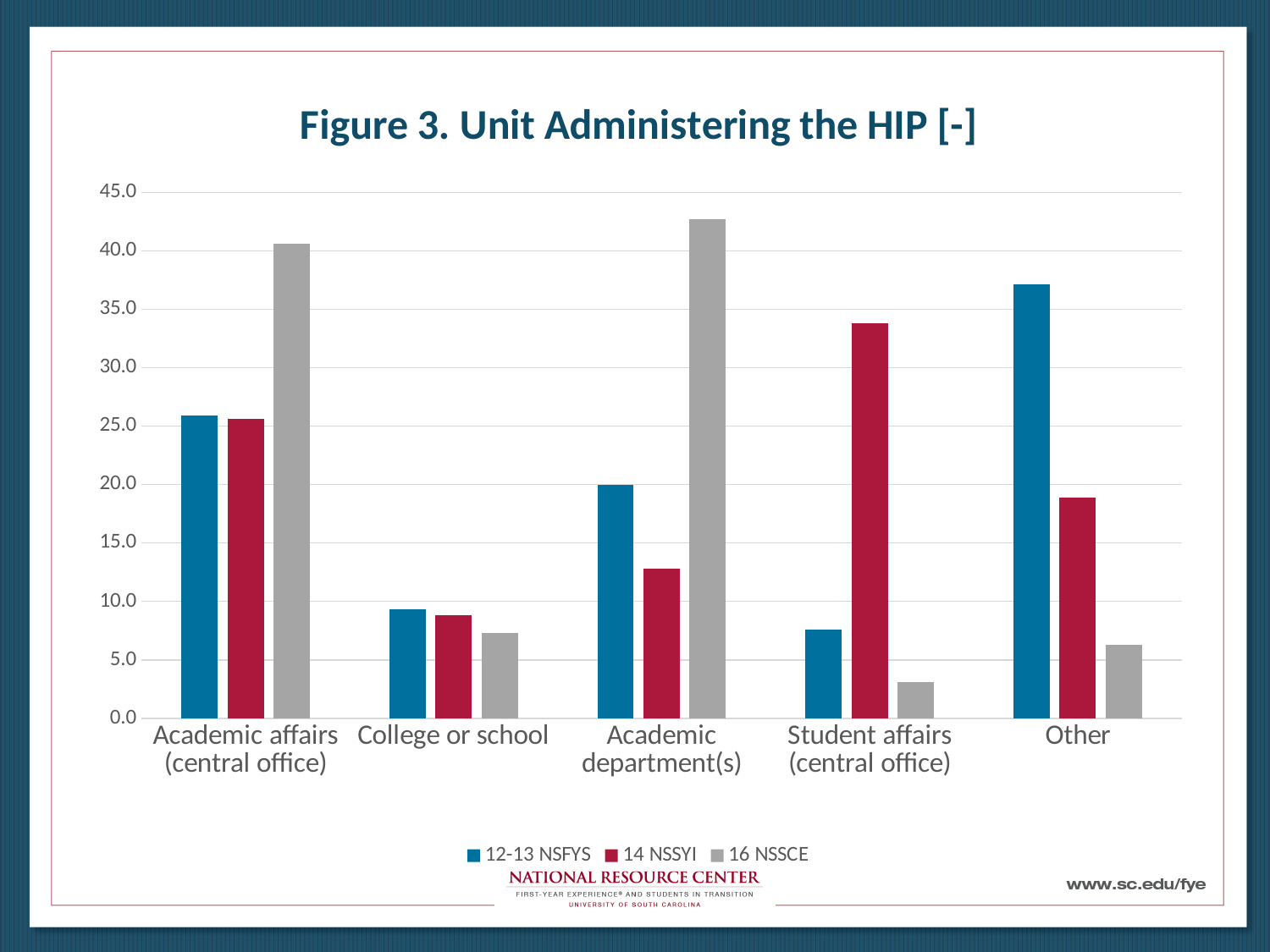
What is the title of the chart? Figure 3. Unit Administering the HIP [-] Which category has the highest value for the 16 NSSCE series? Academic department(s) Is the 14 NSSYI value for Student affairs (central office) greater or less than 30.0? greater Which category has the highest value for the 12-13 NSFYS series? Other Is the 16 NSSCE value for Academic affairs (central office) greater or less than 35.0? greater How many series does the legend list? 3 Which category has the highest value for the 14 NSSYI series? Student affairs (central office) Is the 16 NSSCE value for Other greater or less than 10.0? less How many categories are shown on the x axis? 5 For the Other category, which series has the larger value: 12-13 NSFYS or 14 NSSYI? 12-13 NSFYS What kind of chart is shown on the slide? bar chart Which category has the lowest value for the 16 NSSCE series? Student affairs (central office)